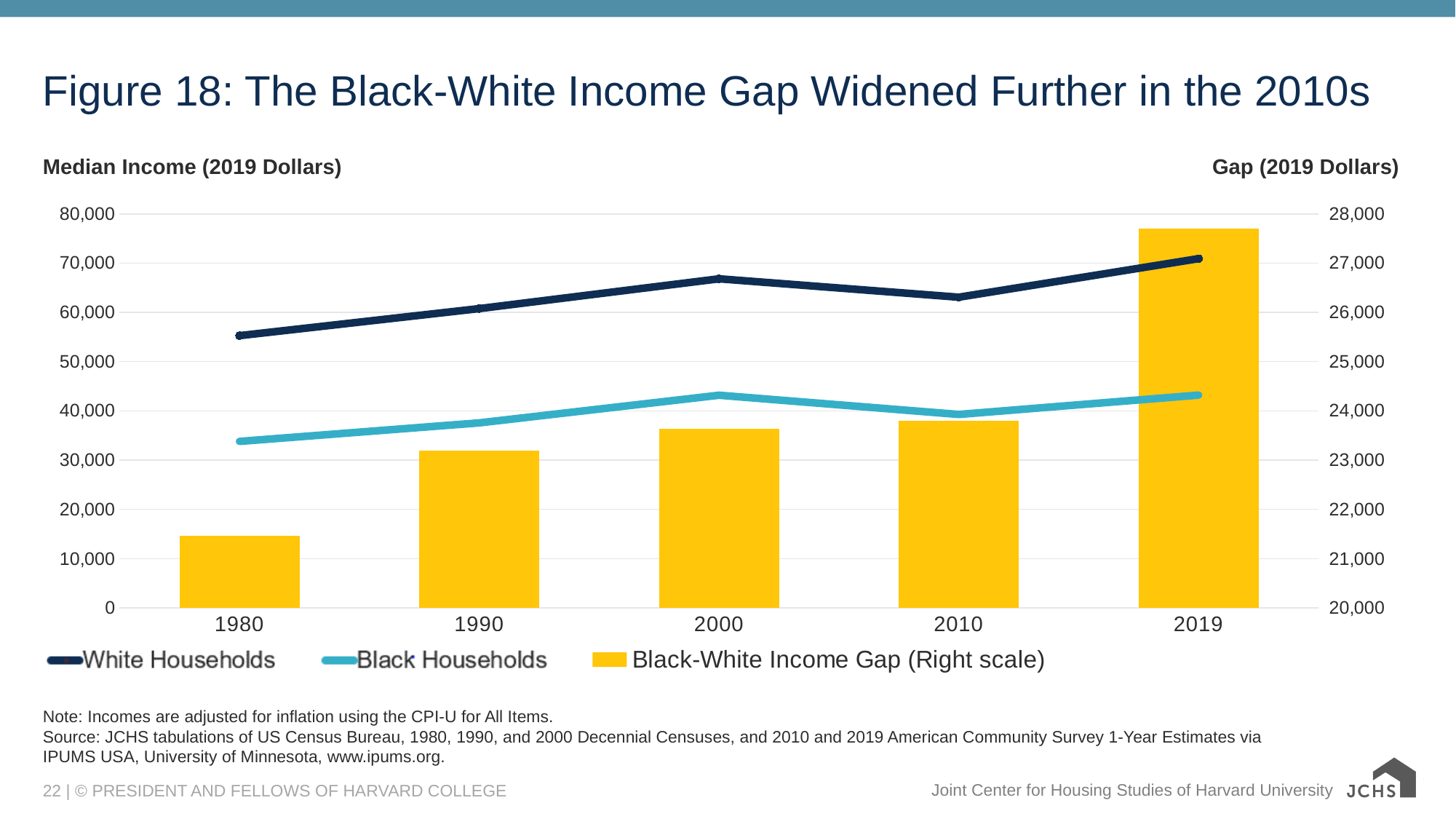
What kind of chart is this? Combined bar and line chart Is the Black-White Income Gap in 2019 greater or less than 27,000 on the right scale? greater In which year is the Black-White Income Gap bar the tallest? 2019 In which year is the Black Households median income lowest? 1980 In which year is the Black-White Income Gap bar the shortest? 1980 Is the White Households median income in 1980 greater or less than 60,000? less Is the Black Households median income in 2000 greater or less than 40,000? greater Which is larger, the White Households median income in 2000 or in 2010? 2000 In which year is the White Households median income highest? 2019 Do the Black-White Income Gap bars generally rise or fall from 1980 to 2019? rise How many series does the legend list? 3 How many years are shown on the x axis? 5